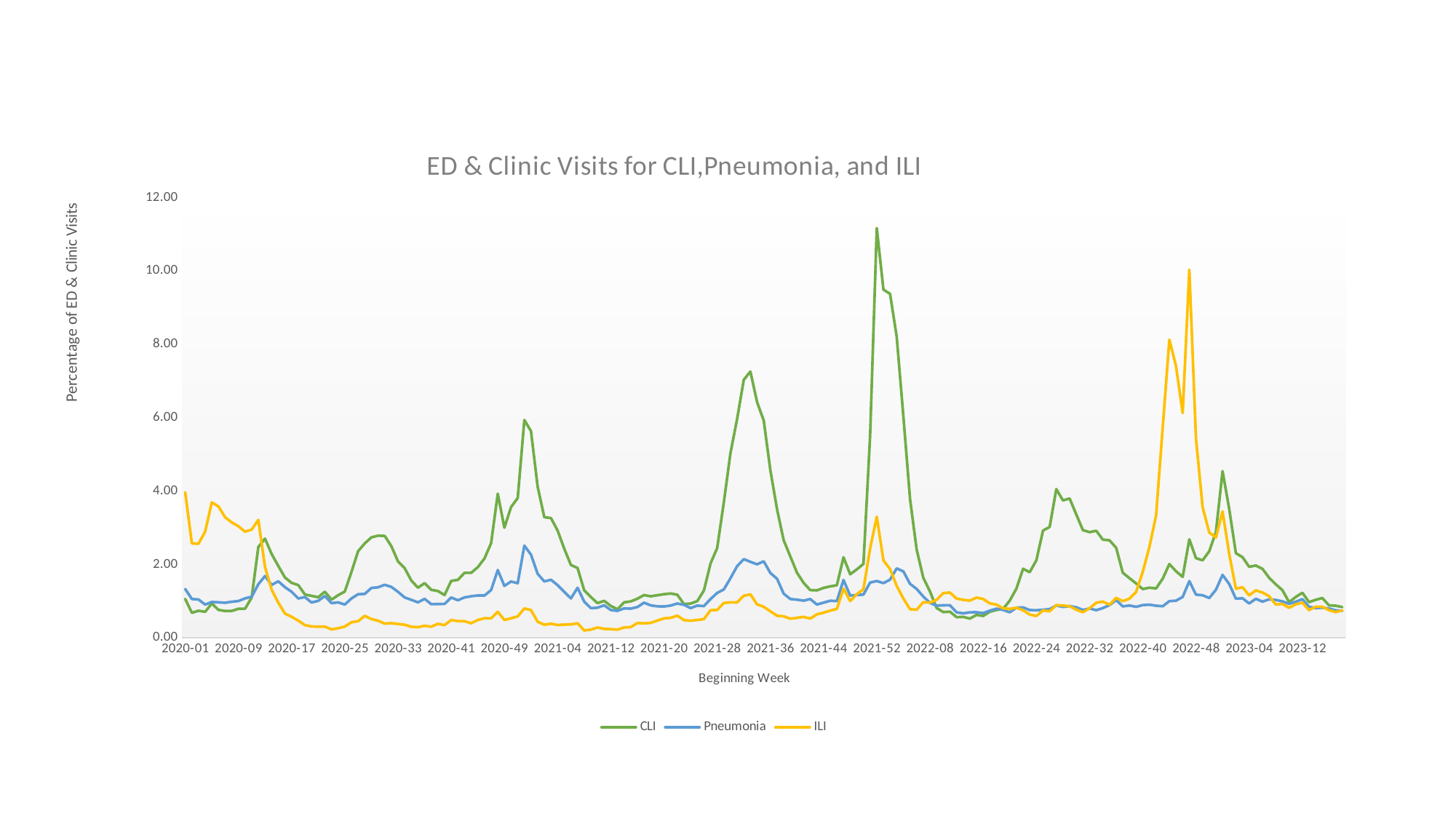
Is the peak value of the CLI series around week 2021-52 greater or less than 10.00? greater Around week 2022-44, which series is larger, ILI or CLI? ILI Which series has the lowest peak value over the whole period? Pneumonia Which series reaches the highest value anywhere on the chart? CLI What is the title of the chart? ED & Clinic Visits for CLI,Pneumonia, and ILI Around week 2021-52, which series is larger, CLI or ILI? CLI What is the label on the vertical axis? Percentage of ED & Clinic Visits Is the peak value of the ILI series around week 2022-44 greater or less than 8.00? greater How many series does the legend list? 3 Is the CLI peak around week 2021-32 greater or less than 6.00? greater What kind of chart is shown on the slide? Line chart